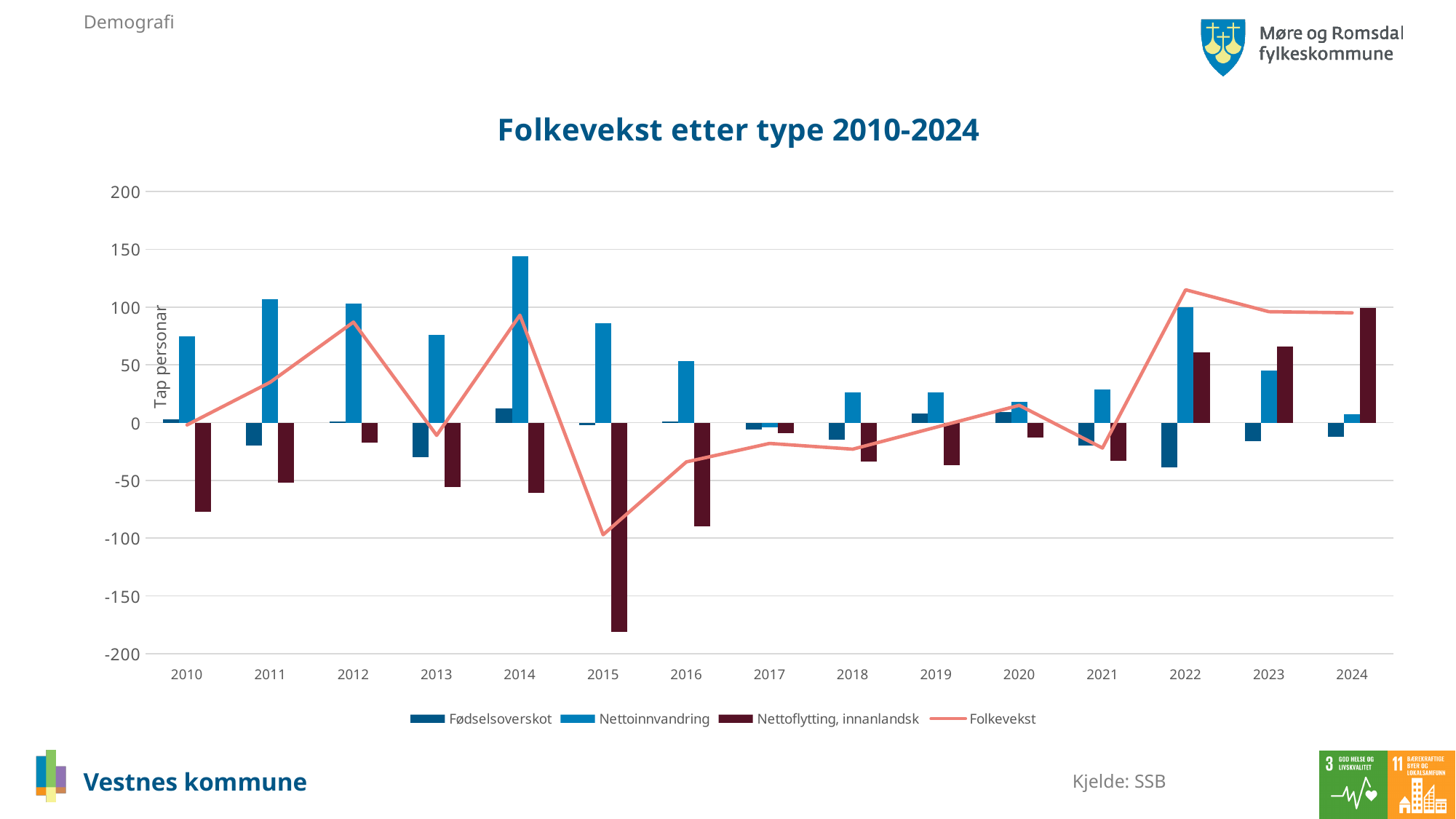
In which year does the Folkevekst line reach its lowest point? 2015 Which year has the larger Nettoinnvandring value, 2011 or 2016? 2011 What kind of chart is shown on the slide? Bar chart with a line How many series does the legend list? 4 Is the Folkevekst value in 2022 greater or less than 100? greater Is the value for Nettoflytting, innanlandsk in 2015 greater or less than -150? less What is the title of the chart? Folkevekst etter type 2010-2024 How many years are shown on the x axis? 15 In which year is Nettoflytting, innanlandsk lowest? 2015 Is the value for Nettoinnvandring in 2014 greater or less than 100? greater In which year is Nettoinnvandring highest? 2014 Does Nettoflytting, innanlandsk rise or fall from 2022 to 2024? rise